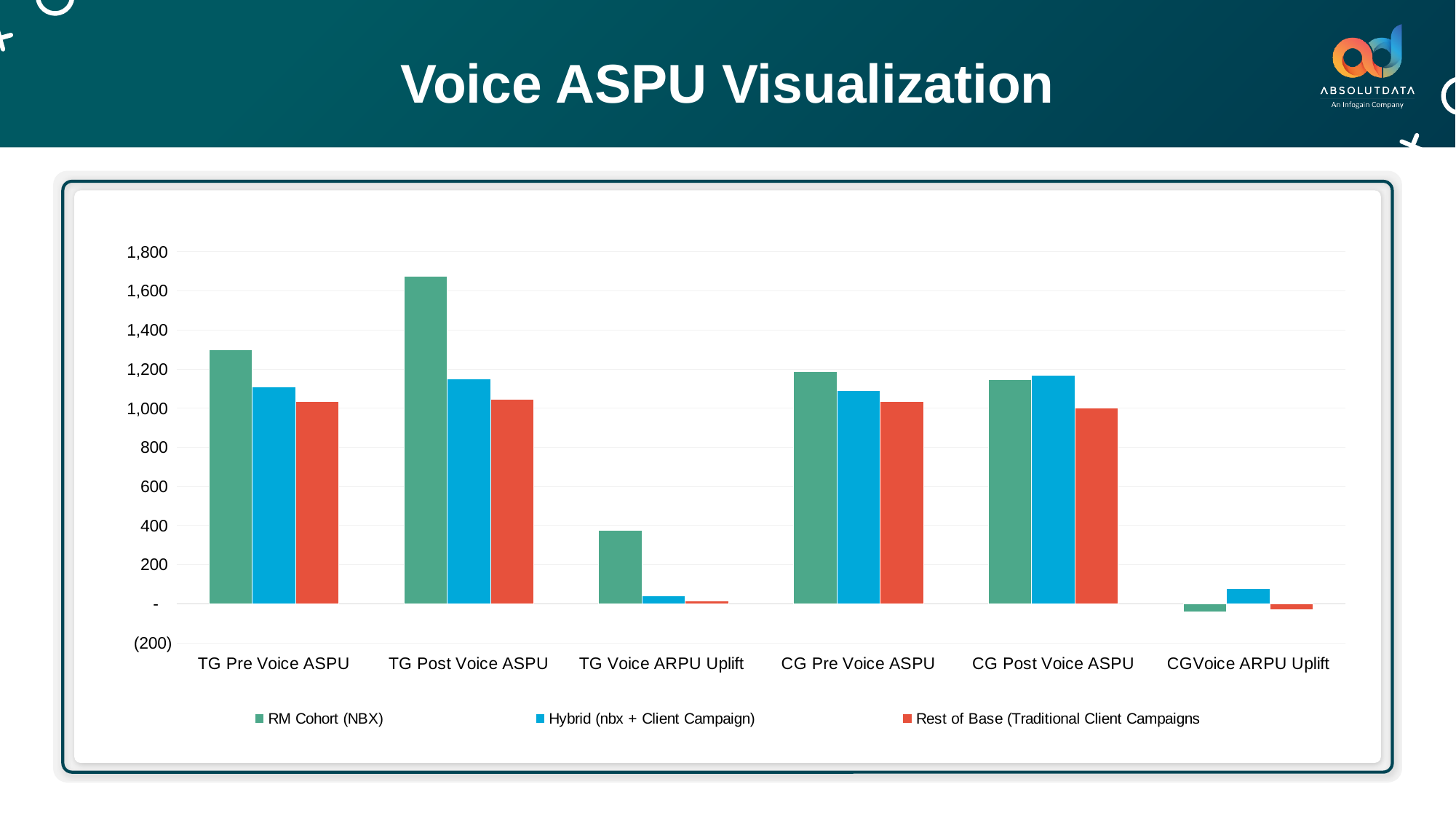
For which category is the RM Cohort (NBX) bar the highest? TG Post Voice ASPU Which colour represents the Rest of Base (Traditional Client Campaigns) series in the legend? Red For CG Post Voice ASPU, which is larger: Hybrid (nbx + Client Campaign) or Rest of Base (Traditional Client Campaigns)? Hybrid (nbx + Client Campaign) How many series does the legend list? 3 Is the RM Cohort (NBX) value for TG Voice ARPU Uplift greater or less than 200? greater Is the Hybrid (nbx + Client Campaign) value for TG Post Voice ASPU greater or less than 1,000? greater How many categories are shown along the x axis? 6 Is the RM Cohort (NBX) value for TG Post Voice ASPU greater or less than 1,600? greater For which category is the RM Cohort (NBX) bar the lowest? CGVoice ARPU Uplift What kind of chart is shown on the slide? Bar chart What is the title of the slide containing the chart? Voice ASPU Visualization For TG Pre Voice ASPU, which is larger: RM Cohort (NBX) or Hybrid (nbx + Client Campaign)? RM Cohort (NBX)